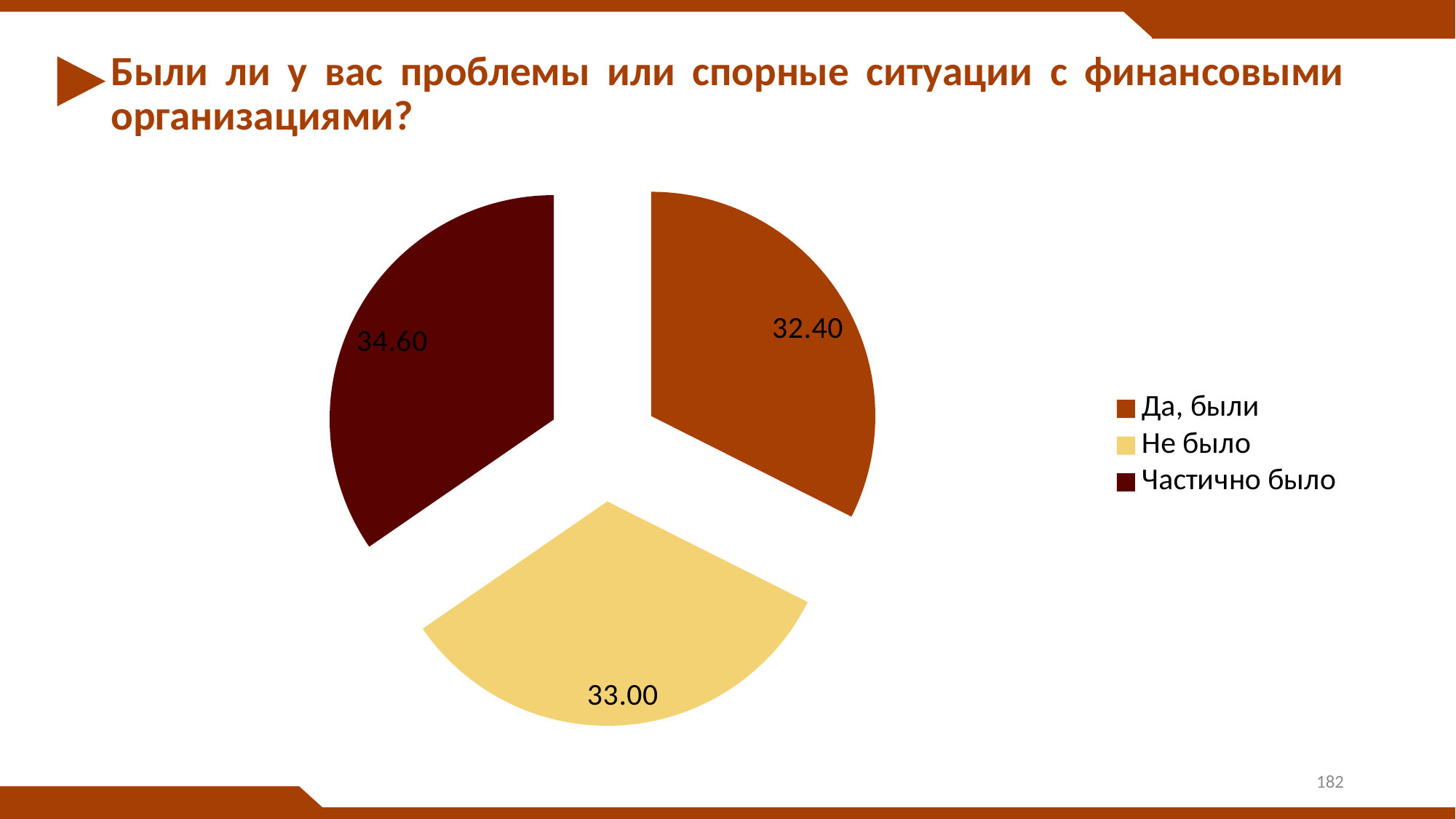
How many entries does the legend list? 3 Which category has the smallest slice of the pie? Да, были How many slices does the pie chart have? 3 What is the difference between the values for "Не было" and "Да, были"? 0.60 What colour is the slice for "Не было"? yellow What is the value for "Да, были"? 32.40 Which is larger, the value for "Не было" or the value for "Частично было"? Частично было What type of chart is shown on the slide? pie chart What is the difference between the values for "Частично было" and "Да, были"? 2.20 What is the value for "Не было"? 33.00 Which category has the largest slice of the pie? Частично было What is the value for "Частично было"? 34.60